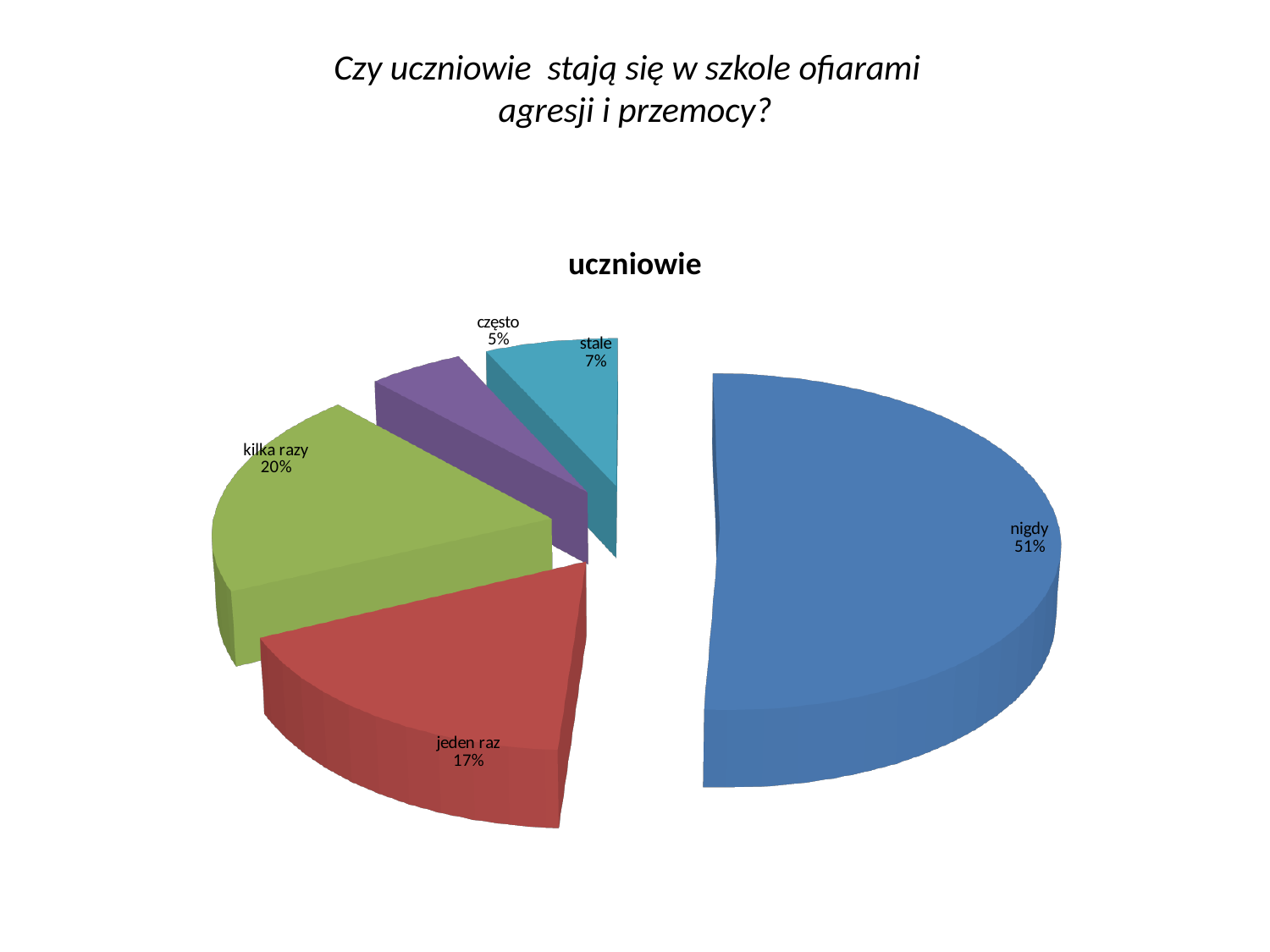
What kind of chart is shown on the slide? pie chart How many slices does the pie chart have? 5 What is the value shown for 'stale'? 7% What is the value shown for 'często'? 5% What share of the pie does the 'nigdy' slice represent? 51% Which category has the smallest slice? często What is the chart's title? uczniowie What is the value shown for 'jeden raz'? 17% Which is larger, the 'stale' slice or the 'często' slice? stale Which category has the largest slice? nigdy What is the value shown for 'kilka razy'? 20% What is the difference between the 'kilka razy' and 'jeden raz' values? 3%